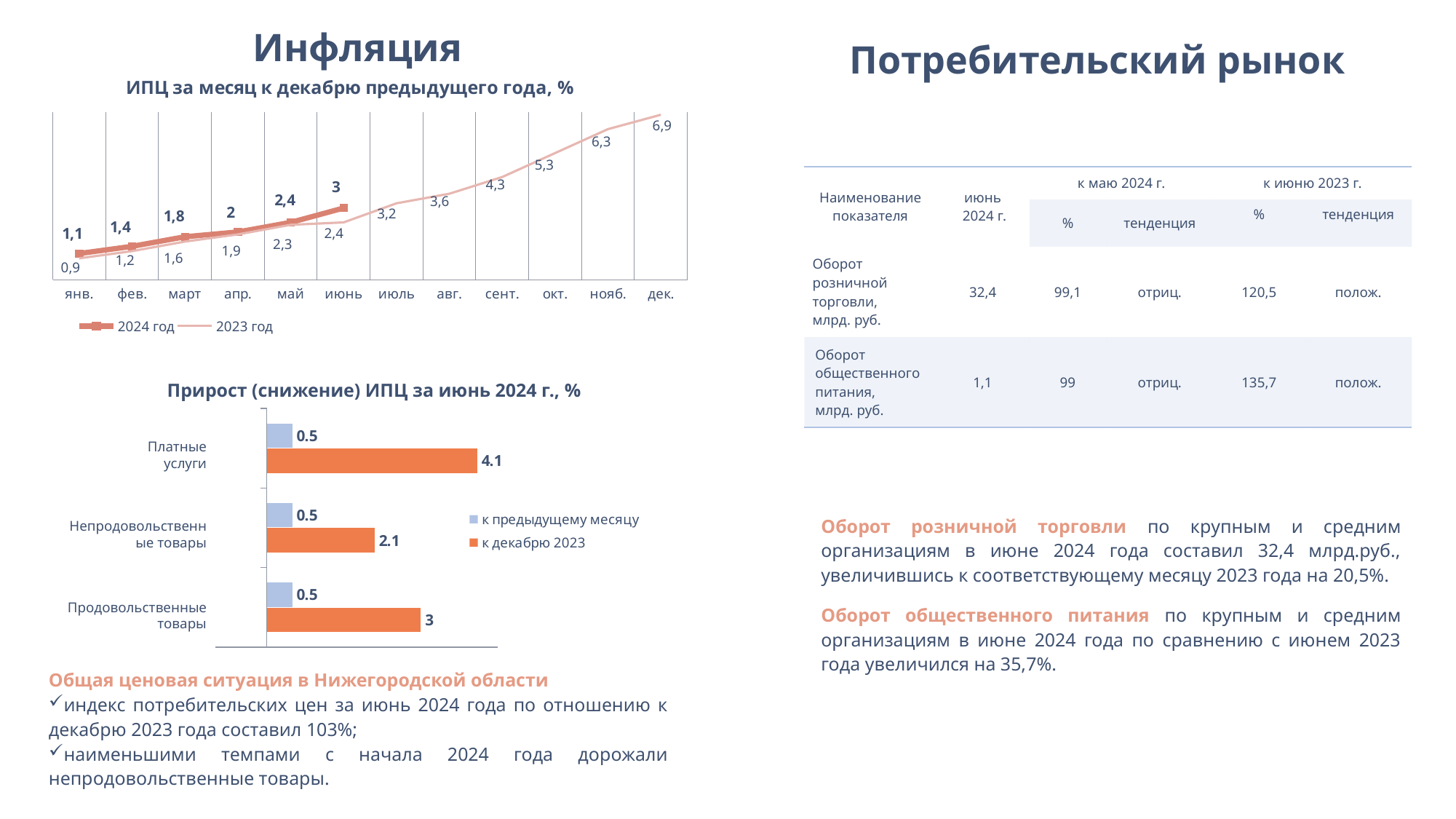
What kind of chart is 'Прирост (снижение) ИПЦ за июнь 2024 г., %'? bar chart In the line chart 'ИПЦ за месяц к декабрю предыдущего года, %', which series has the higher value in июнь, 2024 год or 2023 год? 2024 год In the line chart 'ИПЦ за месяц к декабрю предыдущего года, %', what is the value for 2023 год in сент.? 4,3 In the line chart 'ИПЦ за месяц к декабрю предыдущего года, %', how many months are shown on the x axis? 12 In the line chart 'ИПЦ за месяц к декабрю предыдущего года, %', what is the value for 2024 год in июнь? 3 In the line chart 'ИПЦ за месяц к декабрю предыдущего года, %', do the 2023 год values rise or fall from янв. to дек.? rise In the line chart 'ИПЦ за месяц к декабрю предыдущего года, %', how many series does the legend list? 2 In the bar chart 'Прирост (снижение) ИПЦ за июнь 2024 г., %', what is the value for Платные услуги к декабрю 2023? 4.1 In the bar chart 'Прирост (снижение) ИПЦ за июнь 2024 г., %', what is the difference between Платные услуги and Продовольственные товары к декабрю 2023? 1.1 In the line chart 'ИПЦ за месяц к декабрю предыдущего года, %', what is the difference between the 2024 год and 2023 год values in май? 0,1 In the bar chart 'Прирост (снижение) ИПЦ за июнь 2024 г., %', which category has the lowest value к декабрю 2023? Непродовольственные товары In the line chart 'ИПЦ за месяц к декабрю предыдущего года, %', what is the value for 2023 год in дек.? 6,9